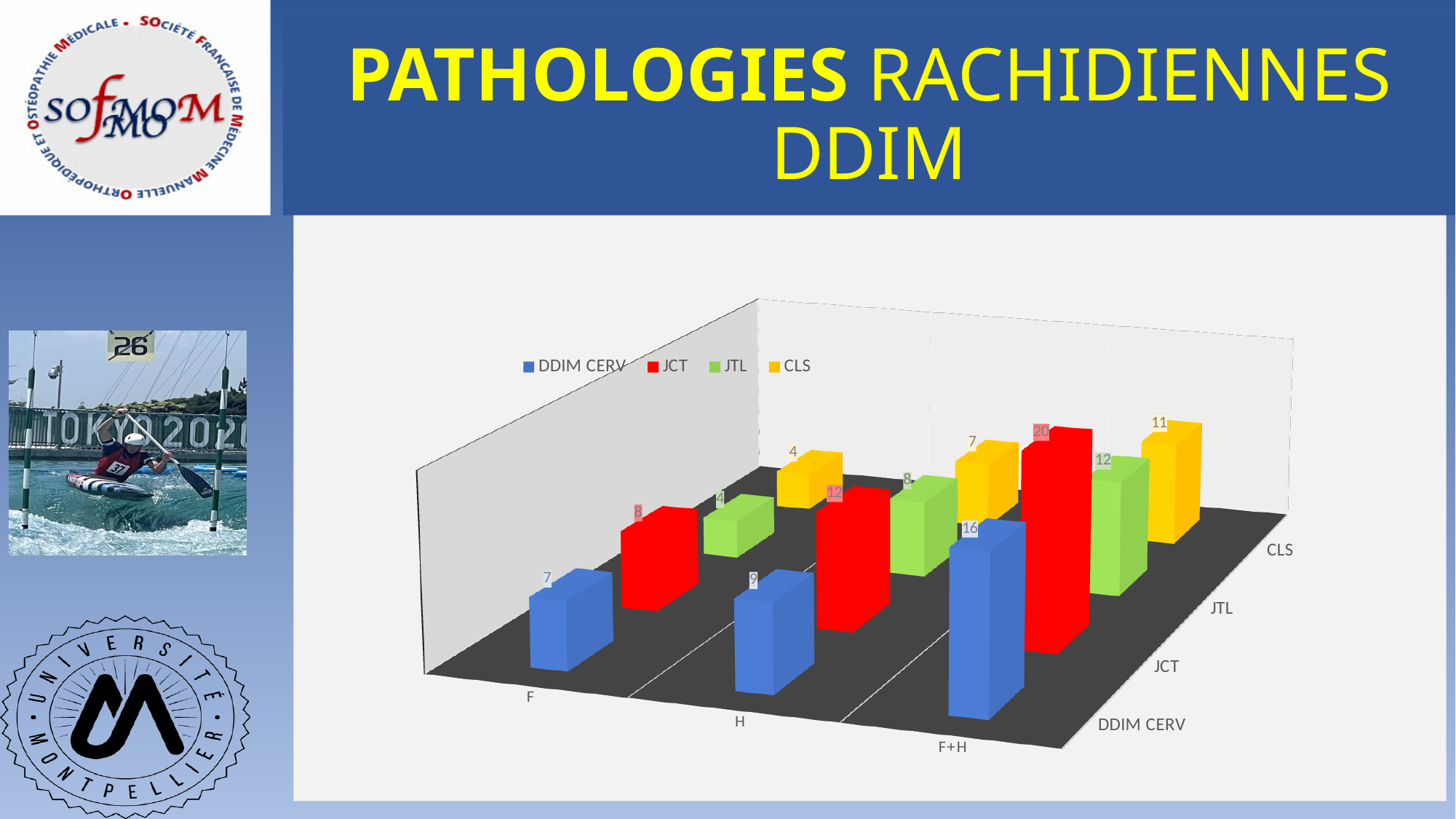
What is the difference between the JCT value and the DDIM CERV value for category F+H? 4 What is the value of JCT for category F+H? 20 What is the value of JTL for category F+H? 12 What kind of chart is shown on the slide? 3D bar chart What is the value of DDIM CERV for category F? 7 How many categories are shown along the x axis? 3 What is the value of CLS for category H? 7 Which is larger, the JTL value for H or the CLS value for H? JTL value for H How many series does the legend list? 4 Do the DDIM CERV values rise or fall from F to F+H? rise Which series has the highest value for category F+H? JCT Which category has the lowest value for the JCT series? F